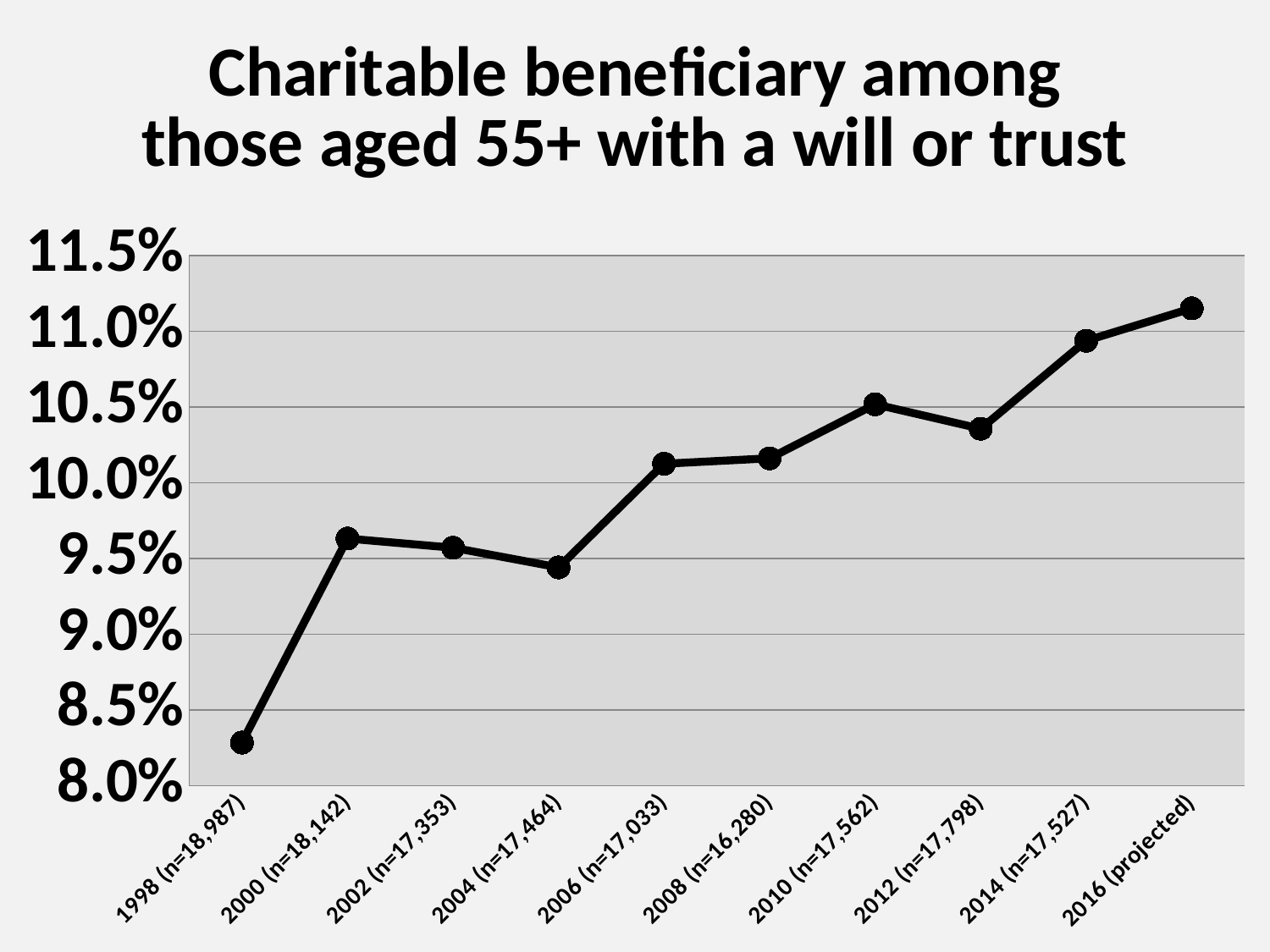
Is the value for 1998 (n=18,987) greater or less than 8.5%? less Which is larger, the value for 2012 (n=17,798) or the value for 2014 (n=17,527)? 2014 (n=17,527) How many data points are plotted on the chart? 10 Which is larger, the value for 2010 (n=17,562) or the value for 2012 (n=17,798)? 2010 (n=17,562) Is the value for 2016 (projected) greater or less than 11.0%? greater Is the value for 2006 (n=17,033) greater or less than 10.0%? greater Which year has the highest value on the chart? 2016 (projected) What kind of chart is shown on the slide? line chart Which year has the lowest value on the chart? 1998 (n=18,987) Do the values generally rise or fall from 1998 to 2016? rise What is the title of the chart? Charitable beneficiary among those aged 55+ with a will or trust